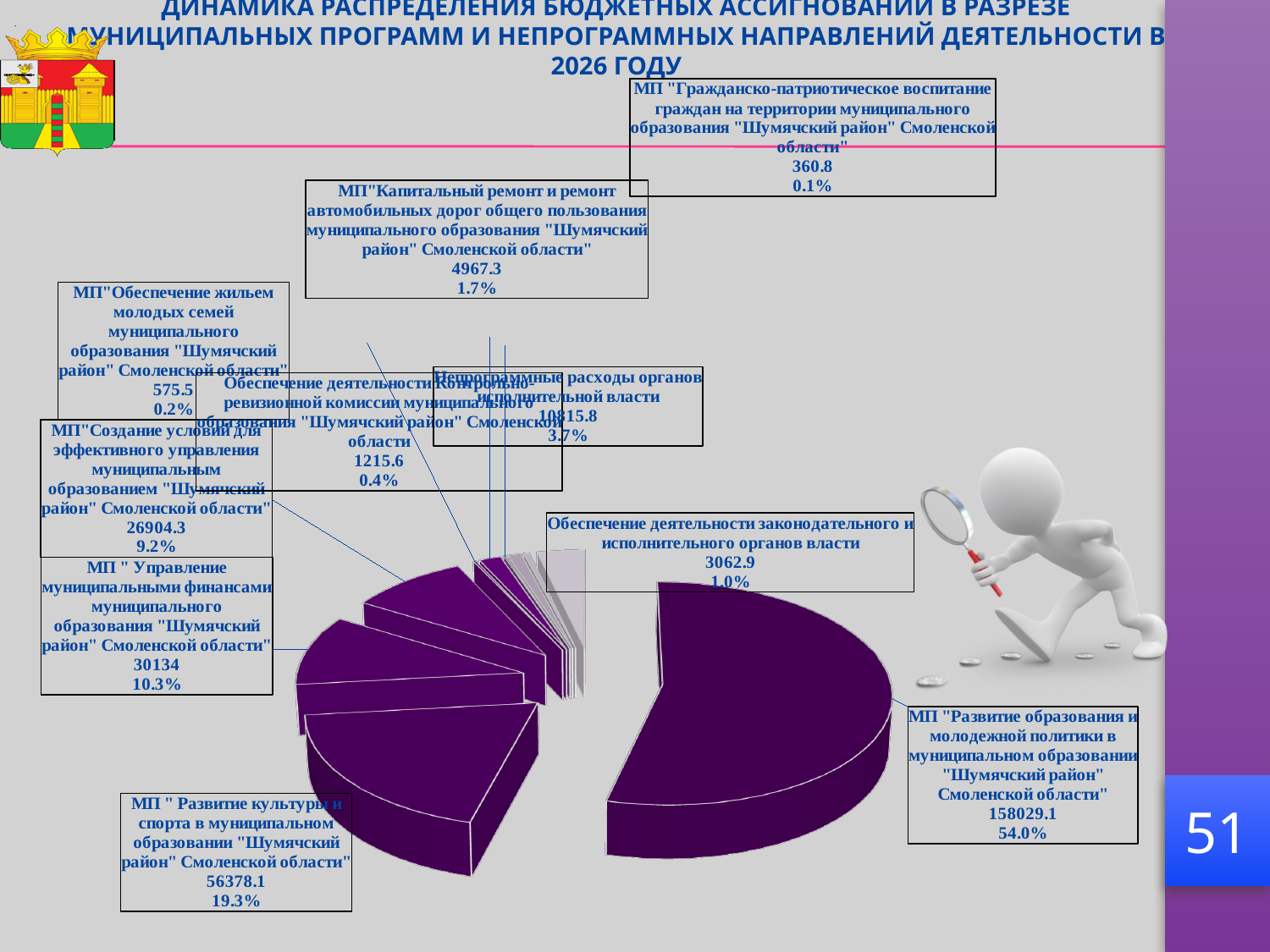
What value is shown for МП "Развитие образования и молодежной политики"? 158029.1 Which category has the smallest slice of the pie? МП "Гражданско-патриотическое воспитание граждан на территории муниципального образования "Шумячский район" Смоленской области" How many slices does the pie chart have? 10 What is the difference between the values for МП "Развитие образования и молодежной политики" and МП "Развитие культуры и спорта"? 101651 What value is shown for МП "Развитие культуры и спорта"? 56378.1 Which category has the largest slice of the pie? МП "Развитие образования и молодежной политики в муниципальном образовании "Шумячский район" Смоленской области" What percentage is shown for МП "Управление муниципальными финансами"? 10.3% What percentage is shown for Непрограммные расходы органов исполнительной власти? 3.7% What kind of chart is shown on the slide? pie chart Which is larger: the value for МП "Управление муниципальными финансами" or for МП "Создание условий для эффективного управления"? МП "Управление муниципальными финансами" What value is shown for МП "Гражданско-патриотическое воспитание граждан"? 360.8 What share of the pie does МП "Развитие образования и молодежной политики" take? 54.0%